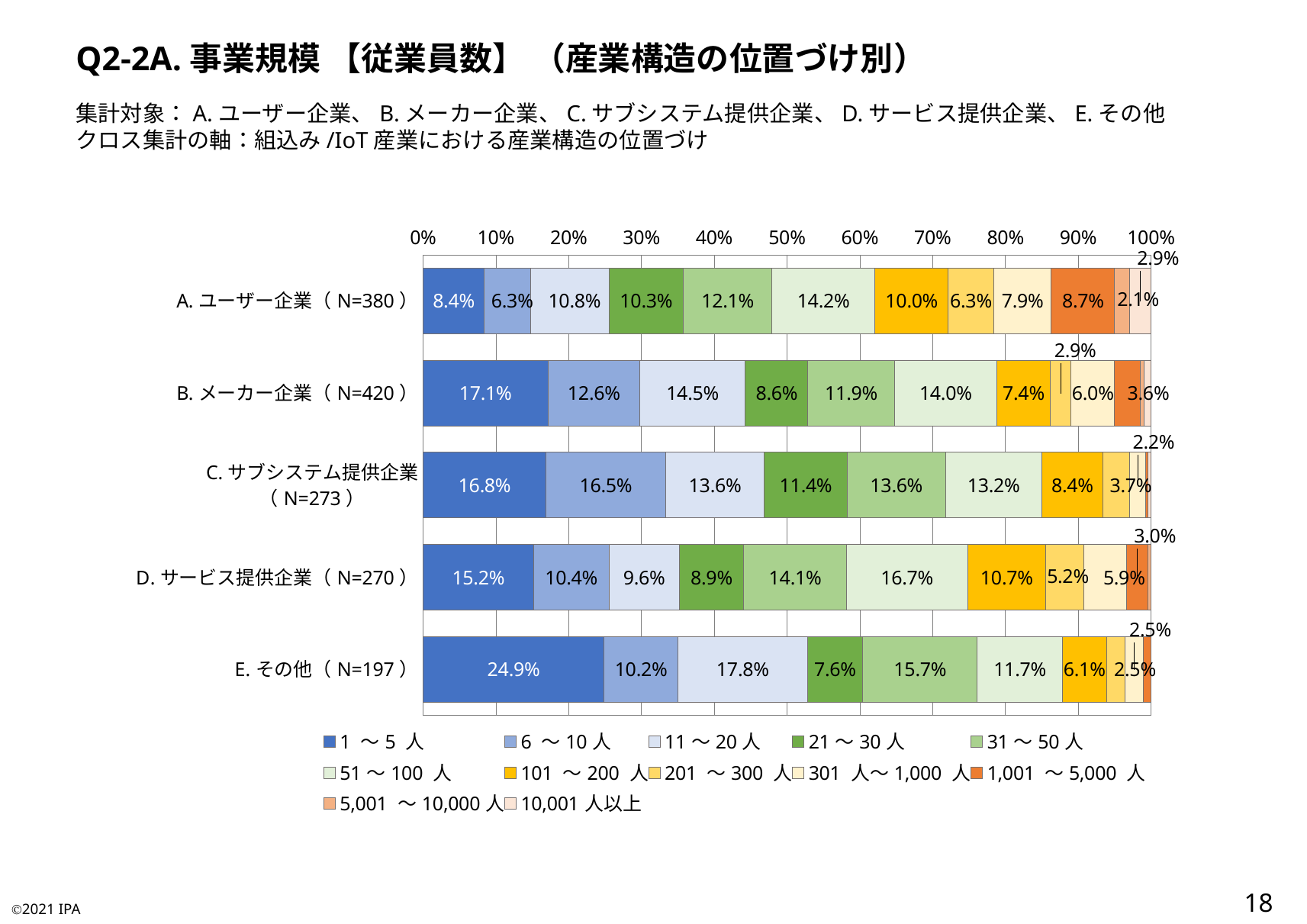
How many series does the legend list? 12 What kind of chart is shown on the slide? Stacked bar chart What is the value of the 1～5人 segment for E. その他? 24.9% Which has the larger 51～100人 share, D. サービス提供企業 or A. ユーザー企業? D. サービス提供企業 How many categories (industry positions) are plotted on the chart? 5 What is the difference between the 1～5人 share for E. その他 and for A. ユーザー企業? 16.5 percentage points What is the sample size (N) shown for C. サブシステム提供企業? 273 Which category has the lowest share for 1～5人? A. ユーザー企業 What is the value of the 101～200人 segment for D. サービス提供企業? 10.7% What is the value of the 21～30人 segment for A. ユーザー企業? 10.3% Which category has the highest share for 1～5人? E. その他 What is the value of the 11～20人 segment for B. メーカー企業? 14.5%